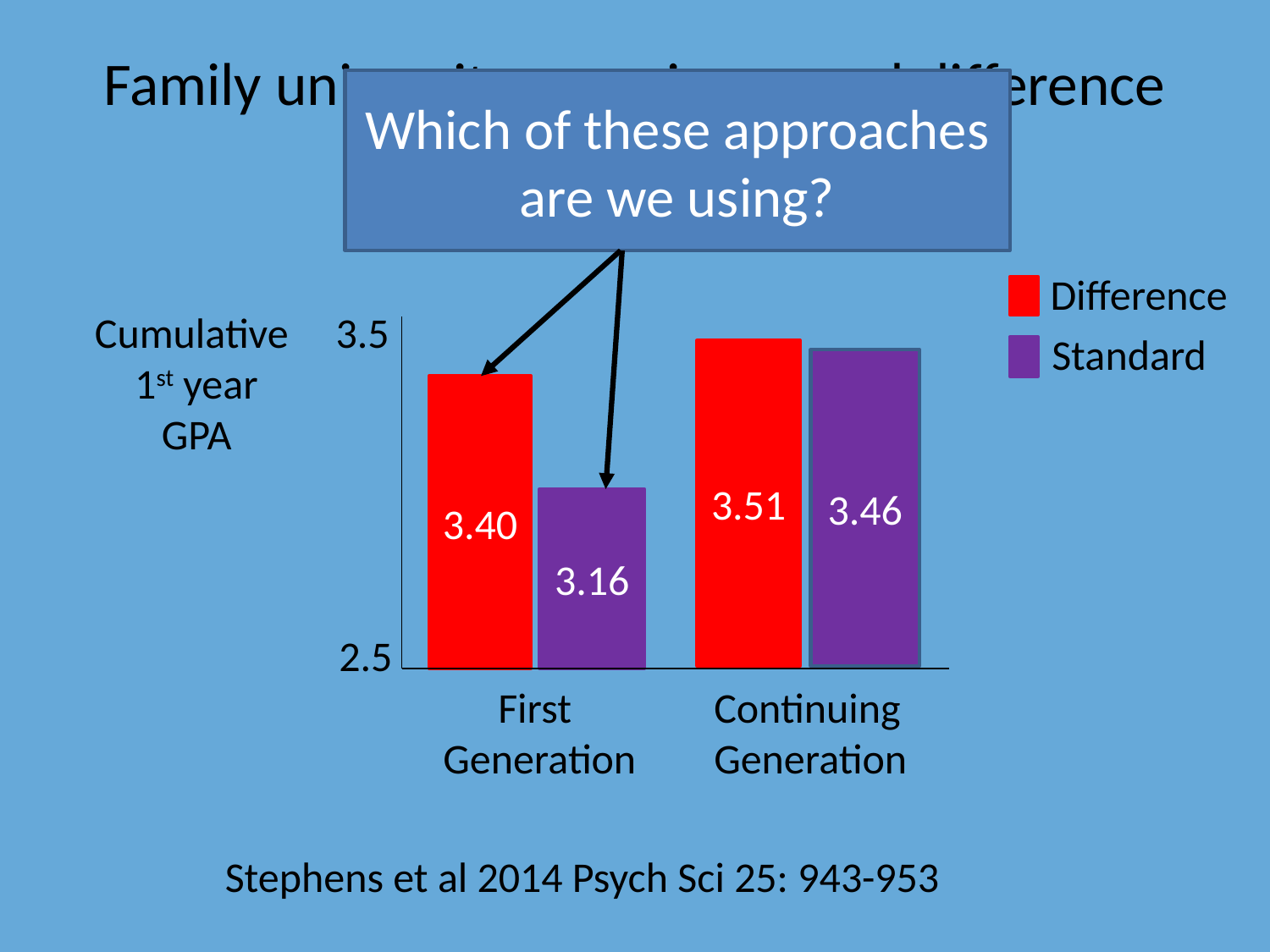
What is the value for the Standard series for First Generation? 3.16 How many series does the legend list? 2 What is the difference between the Difference and Standard values for First Generation? 0.24 Which is larger for First Generation, the Difference value or the Standard value? Difference Which bar has the lowest value on the chart? Standard, First Generation Which bar has the highest value on the chart? Difference, Continuing Generation What is the value for the Standard series for Continuing Generation? 3.46 What kind of chart is shown on the slide? Bar chart How many categories are shown on the x axis? 2 What is the value for the Difference series for First Generation? 3.40 What is the value for the Difference series for Continuing Generation? 3.51 What is the difference between the Difference and Standard values for Continuing Generation? 0.05